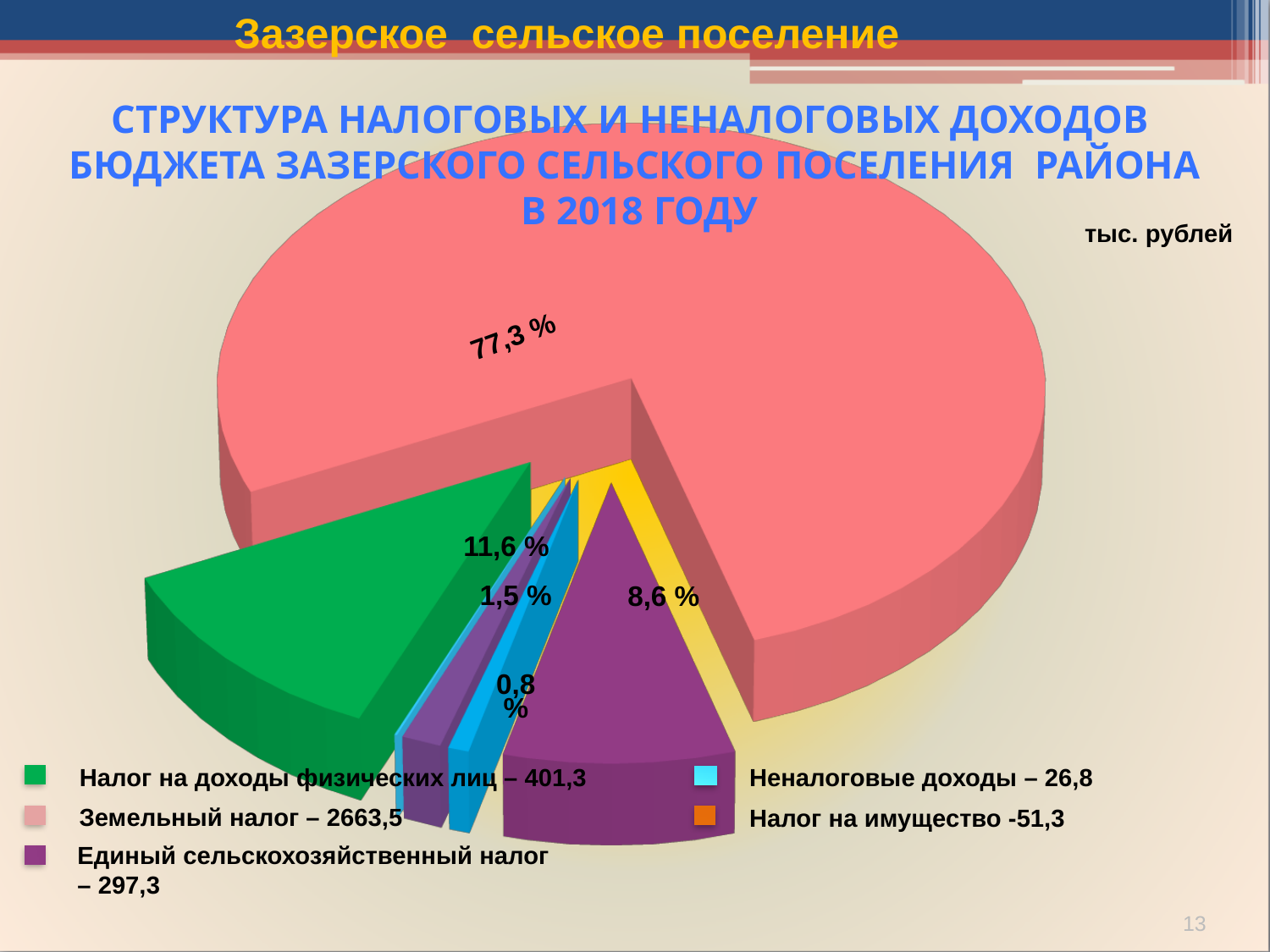
How many categories does the legend of the pie chart list? 5 What is the value for Неналоговые доходы? 26,8 What is the value for Налог на имущество? 51,3 What is the value for Земельный налог? 2663,5 What kind of chart is shown on the slide? pie chart Which is larger, the value for Единый сельскохозяйственный налог or the value for Налог на имущество? Единый сельскохозяйственный налог In what units are the values on the chart given, according to the slide? тыс. рублей Which category has the largest share of the pie? Земельный налог What is the value for Налог на доходы физических лиц? 401,3 What percentage share of the pie is labelled on the largest slice? 77,3 % What is the difference between the values for Земельный налог and Налог на доходы физических лиц? 2262,2